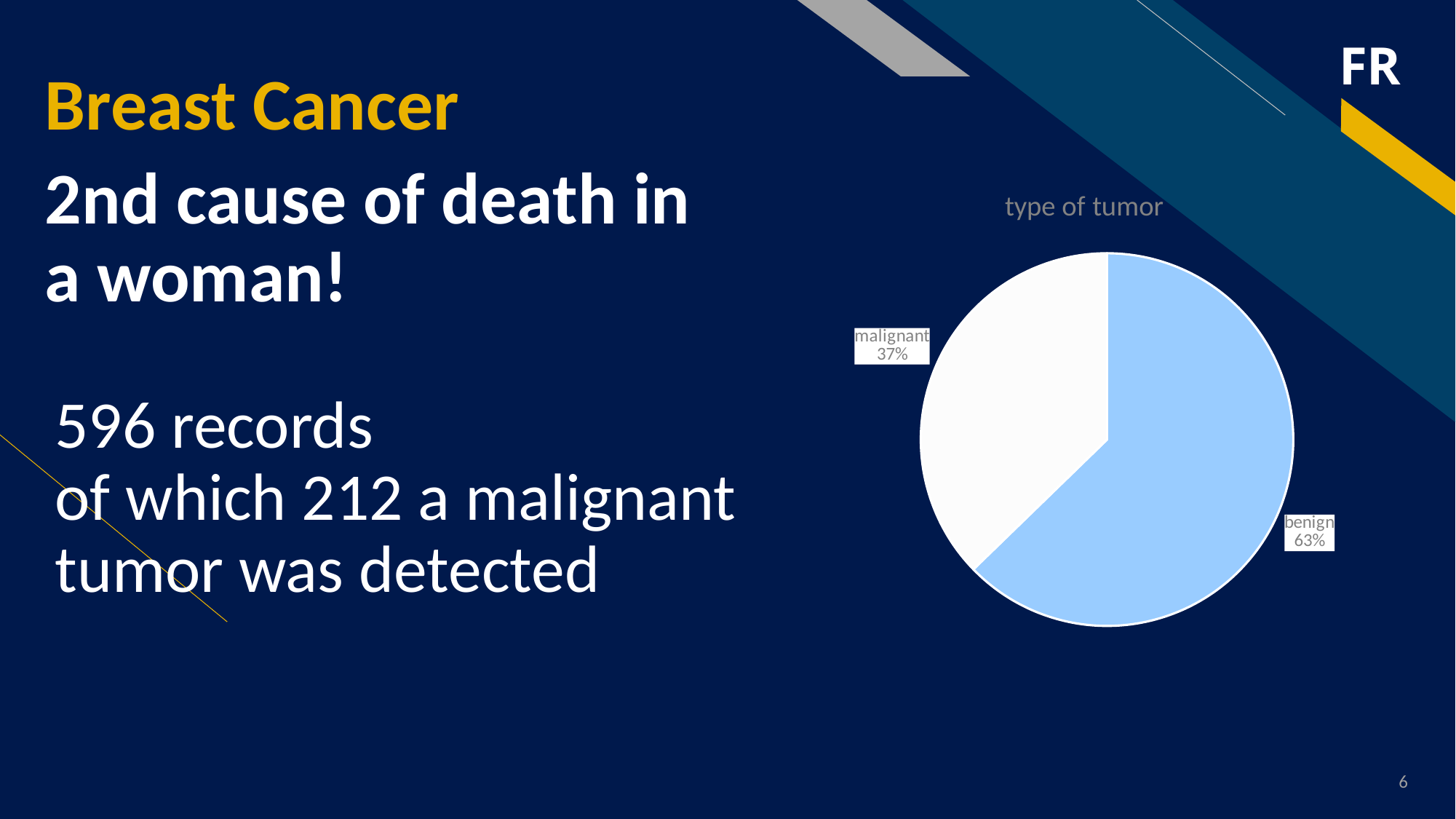
Which slice of the pie is the largest? benign Which is larger, the benign slice or the malignant slice? benign What share of the pie is labelled benign? 63% What is the difference in percentage points between the benign and malignant slices? 26% How many slices does the pie chart have? 2 What type of chart is shown on the slide? pie chart What share of the pie is labelled malignant? 37% What colour is the benign slice of the pie? light blue What is the title of the chart? type of tumor Which slice of the pie is the smallest? malignant